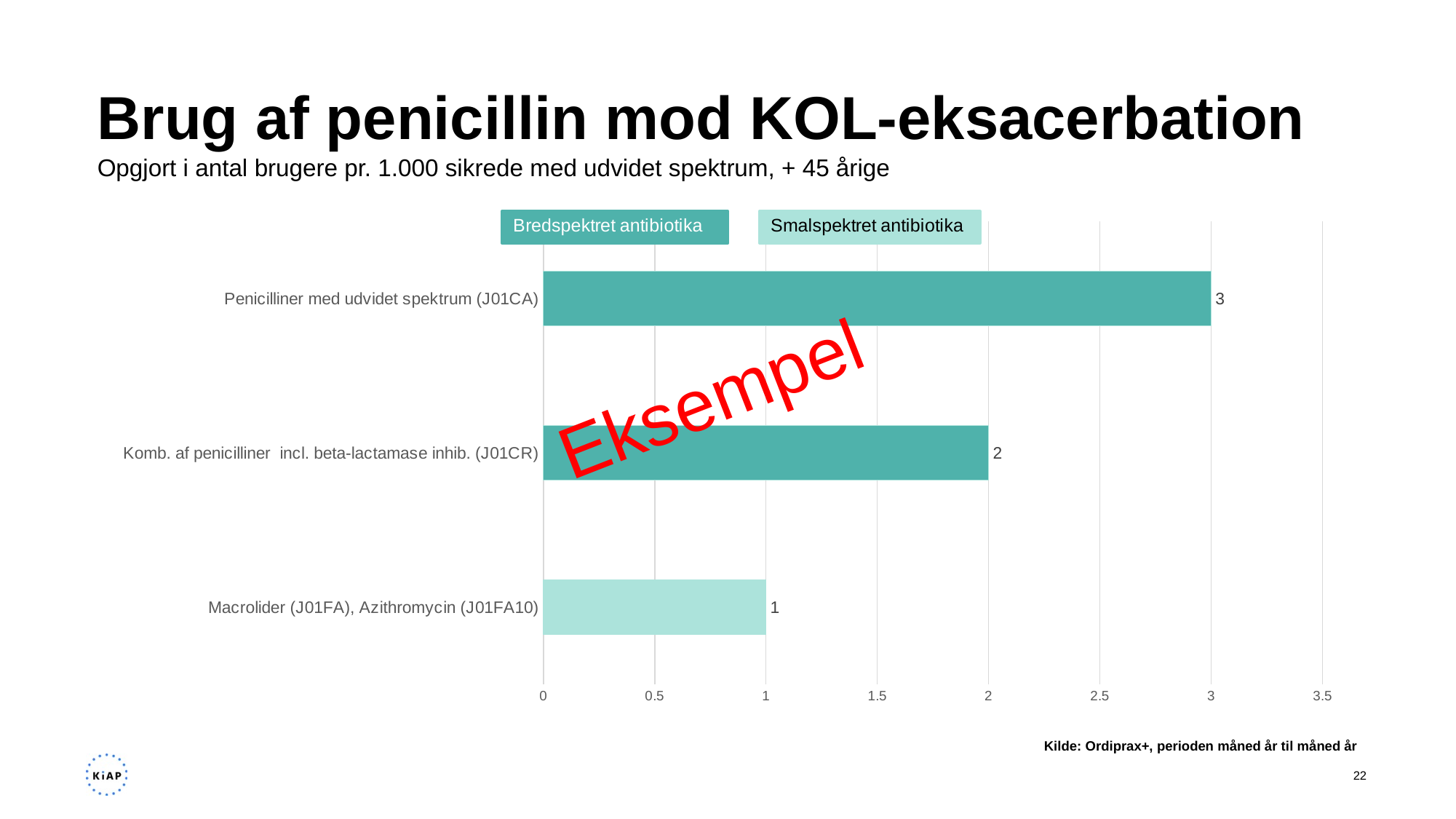
Which is larger: the value for Komb. af penicilliner incl. beta-lactamase inhib. (J01CR) or the value for Macrolider (J01FA), Azithromycin (J01FA10)? Komb. af penicilliner incl. beta-lactamase inhib. (J01CR) How many categories are shown in the chart? 3 How many series does the legend list? 2 What kind of chart is shown on the slide? bar chart What is the value for Komb. af penicilliner incl. beta-lactamase inhib. (J01CR)? 2 Which category has the highest value? Penicilliner med udvidet spektrum (J01CA) Which legend entry does the bar for Macrolider (J01FA), Azithromycin (J01FA10) belong to? Smalspektret antibiotika What is the value for Penicilliner med udvidet spektrum (J01CA)? 3 What is the value for Macrolider (J01FA), Azithromycin (J01FA10)? 1 Which category has the lowest value? Macrolider (J01FA), Azithromycin (J01FA10) Is the value for Penicilliner med udvidet spektrum (J01CA) greater or less than 2.5? greater What is the difference between the values for Penicilliner med udvidet spektrum (J01CA) and Macrolider (J01FA), Azithromycin (J01FA10)? 2